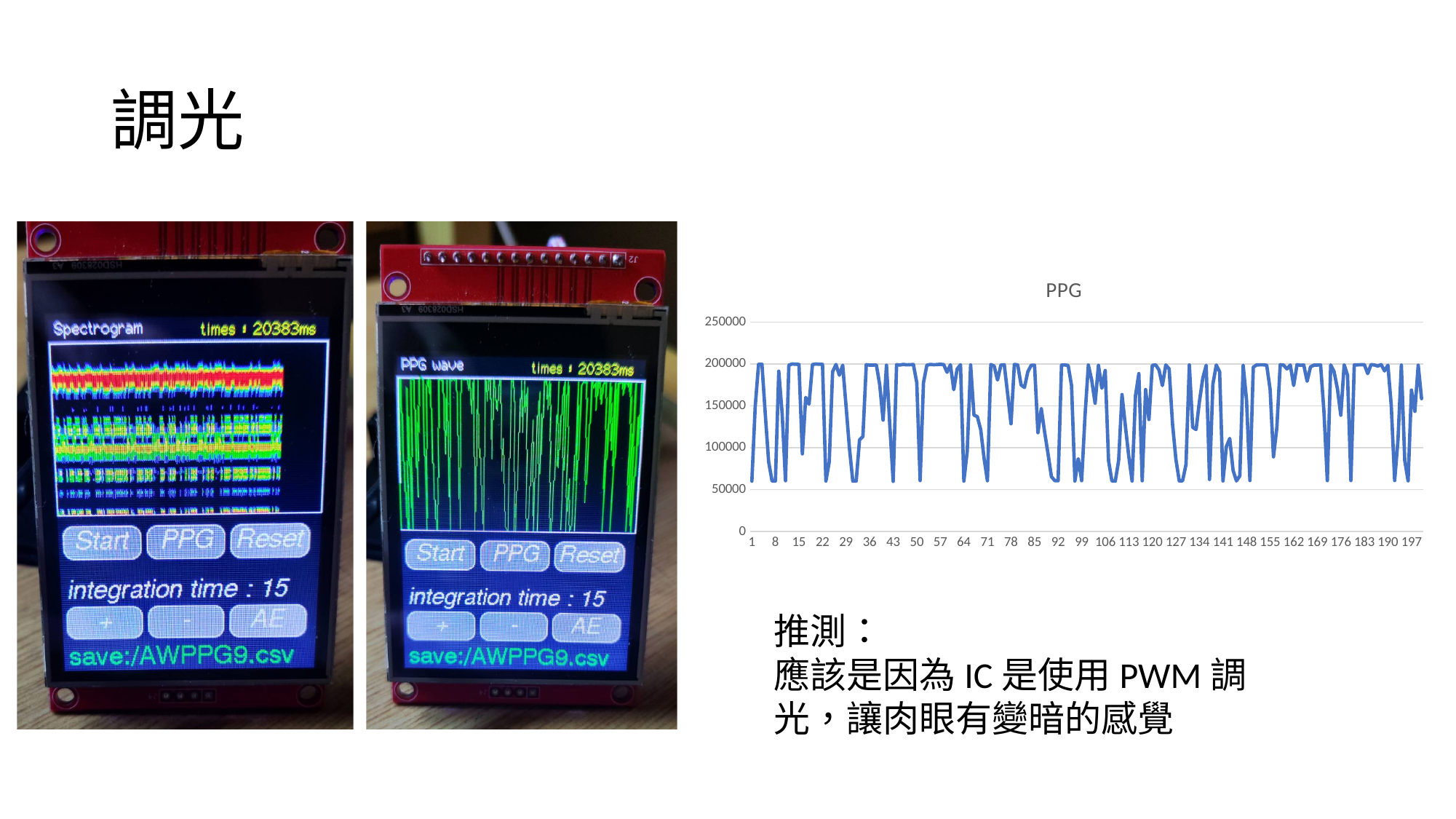
Does the PPG line ever reach the 250000 gridline? no Does the PPG line show a steady rise, a steady fall, or repeated oscillation along the x axis? repeated oscillation Is the highest value reached by the PPG line greater or less than 150000? greater What is the last label shown on the chart's x axis? 197 How many labels are printed along the chart's x axis? 29 What is the highest value shown on the chart's y axis? 250000 Is the value of the PPG line at x = 1 greater or less than 150000? less What kind of chart is shown on the slide? line chart What is the title of the chart? PPG